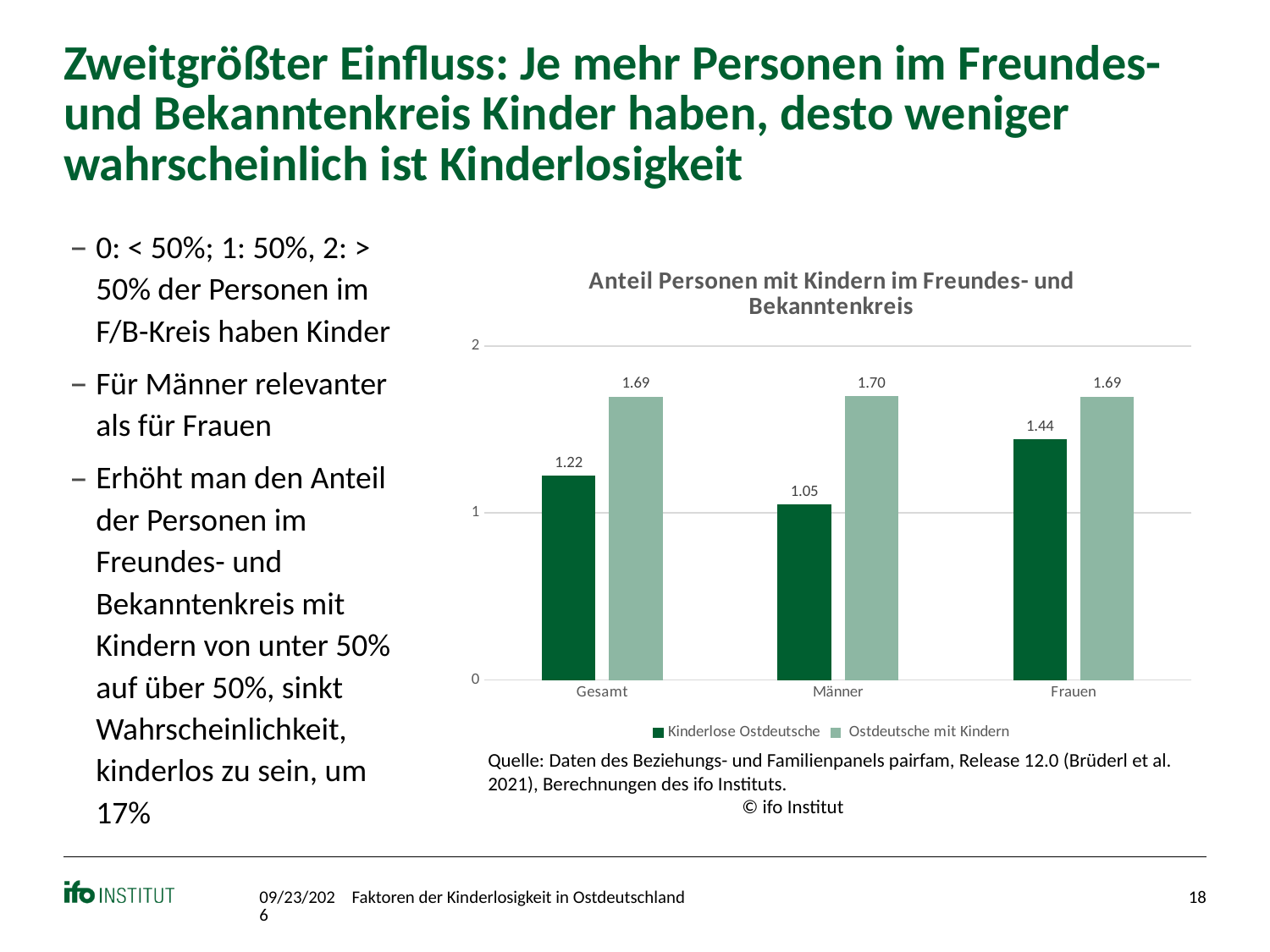
What is the value for Kinderlose Ostdeutsche in the Frauen category? 1.44 What is the value for Ostdeutsche mit Kindern in the Männer category? 1.70 Which is larger in the Gesamt category: Kinderlose Ostdeutsche or Ostdeutsche mit Kindern? Ostdeutsche mit Kindern What is the value for Kinderlose Ostdeutsche in the Gesamt category? 1.22 What kind of chart is shown on the slide? Bar chart What is the difference between Ostdeutsche mit Kindern and Kinderlose Ostdeutsche in the Frauen category? 0.25 What is the title of the chart? Anteil Personen mit Kindern im Freundes- und Bekanntenkreis How many series does the chart legend list? 2 How many categories are shown on the x axis of the chart? 3 What is the difference between Ostdeutsche mit Kindern and Kinderlose Ostdeutsche in the Männer category? 0.65 Which category has the lowest value for Kinderlose Ostdeutsche? Männer Which category has the highest value for Kinderlose Ostdeutsche? Frauen